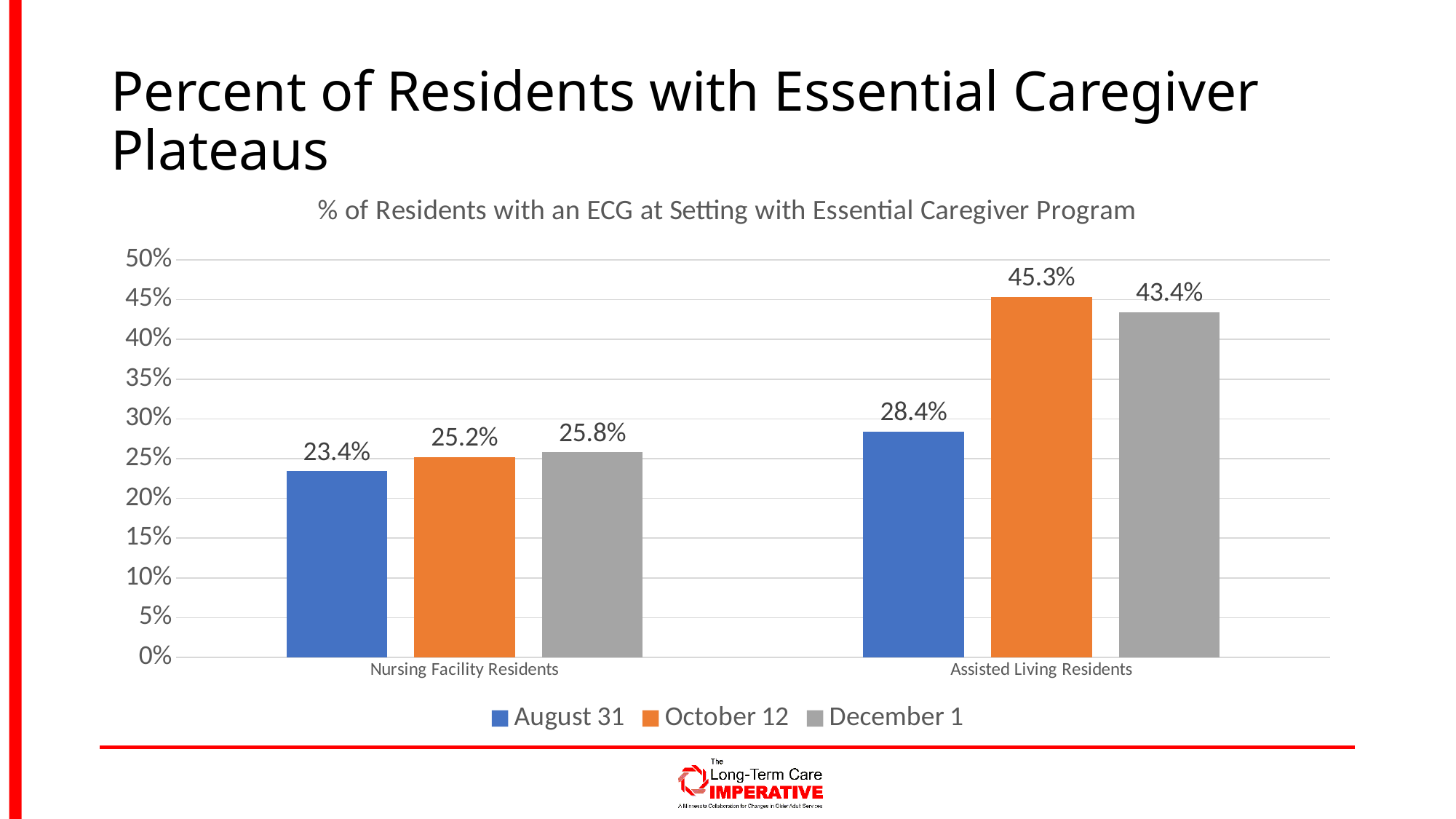
What is the difference between the October 12 and August 31 values for Assisted Living Residents? 16.9% What is the value for Nursing Facility Residents on August 31? 23.4% Which is larger: the December 1 value for Nursing Facility Residents or the August 31 value for Assisted Living Residents? August 31 value for Assisted Living Residents Is the October 12 value for Assisted Living Residents greater or less than 40%? greater How many series does the legend list? 3 What is the value for Assisted Living Residents on December 1? 43.4% How many categories are shown on the x axis? 2 Which series has the highest value for Assisted Living Residents? October 12 What kind of chart is shown on the slide? bar chart Which series has the lowest value for Nursing Facility Residents? August 31 What is the difference between the December 1 and August 31 values for Nursing Facility Residents? 2.4% What is the value for Assisted Living Residents on October 12? 45.3%